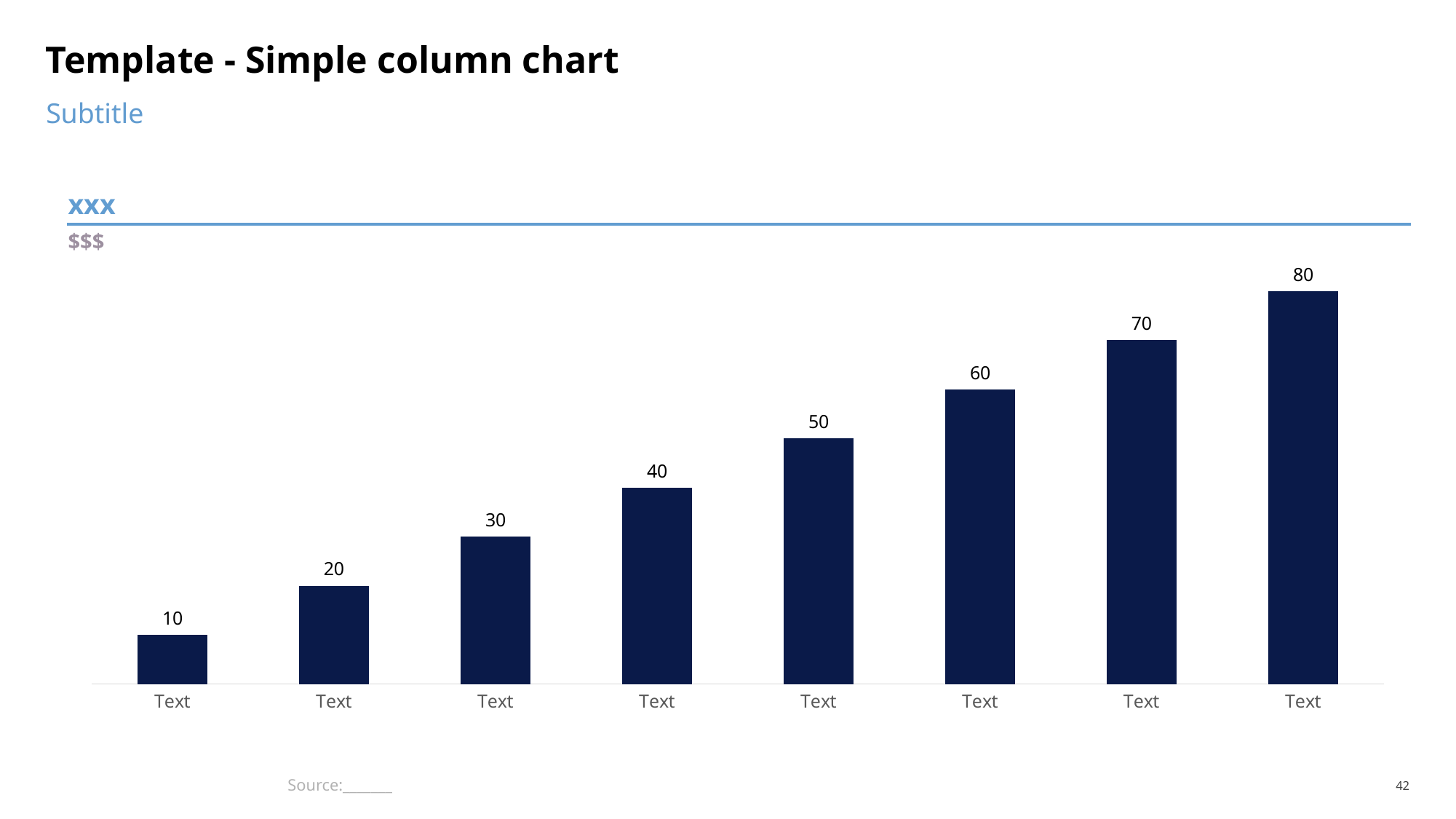
What is the value of the sixth bar from the left? 60 Do the bar values rise or fall from left to right? rise What is the difference between the rightmost bar and the leftmost bar? 70 What is the value of the fourth bar from the left? 40 What is the value of the rightmost bar? 80 What is the title of the slide? Template - Simple column chart Which bar has the lowest value? the leftmost bar (10) What is the value of the leftmost bar? 10 Which bar has the highest value? the rightmost bar (80) Which is larger, the third bar from the left or the fifth bar from the left? the fifth bar (50) How many bars does the chart have? 8 What kind of chart is shown on the slide? bar chart